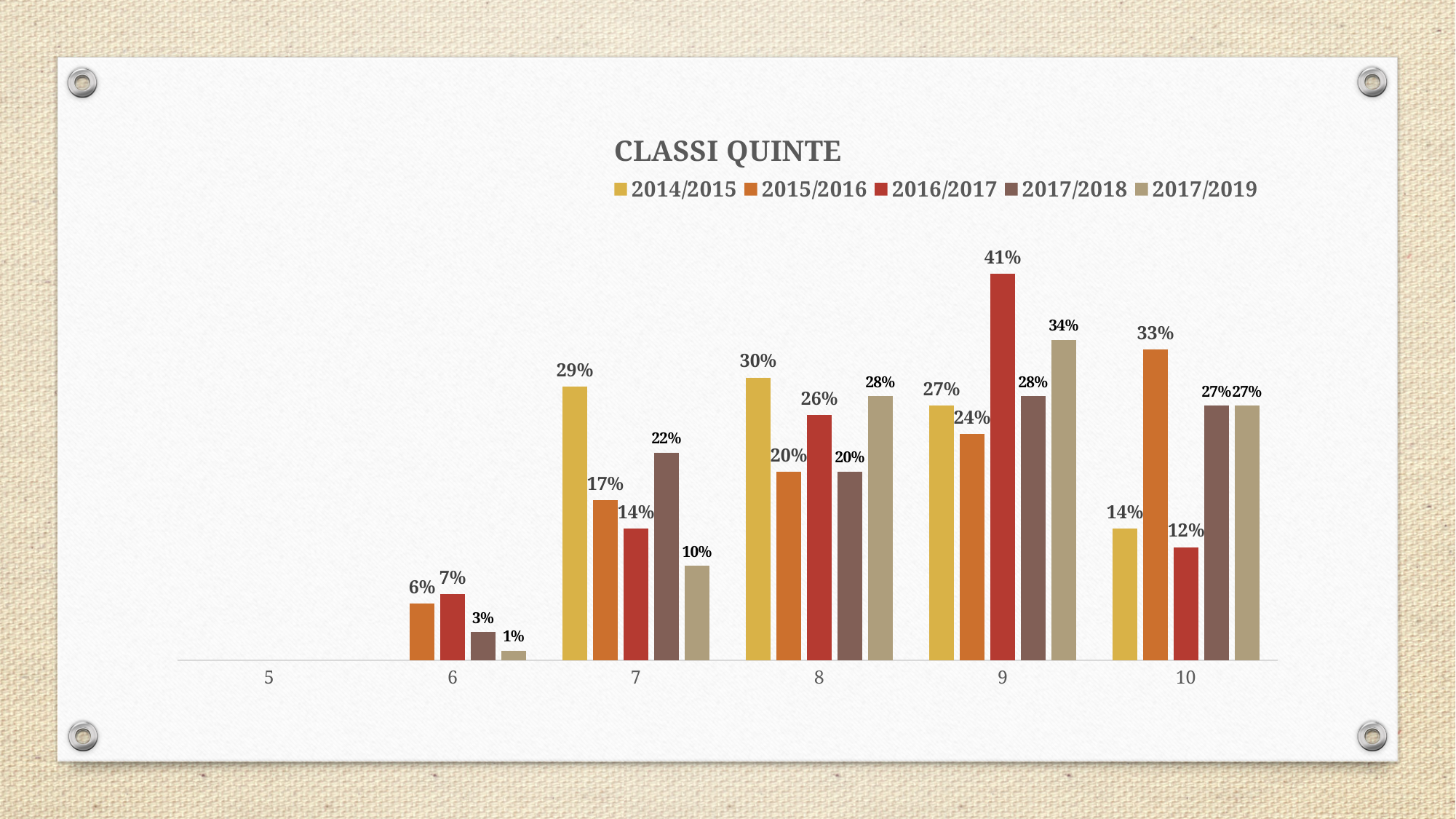
How many categories are shown on the x axis? 6 What is the value for 2014/2015 at category 7? 29% What is the value for 2017/2019 at category 6? 1% What is the title of the chart? CLASSI QUINTE What is the value for 2016/2017 at category 9? 41% Which category has the lowest value for the 2017/2018 series? 6 What is the value for 2017/2019 at category 8? 28% What type of chart is shown on the slide? bar chart Which category has the highest value for the 2015/2016 series? 10 How many series does the legend list? 5 At category 10, which is larger: the 2015/2016 value or the 2014/2015 value? 2015/2016 What is the difference between the 2016/2017 value and the 2015/2016 value at category 9? 17%